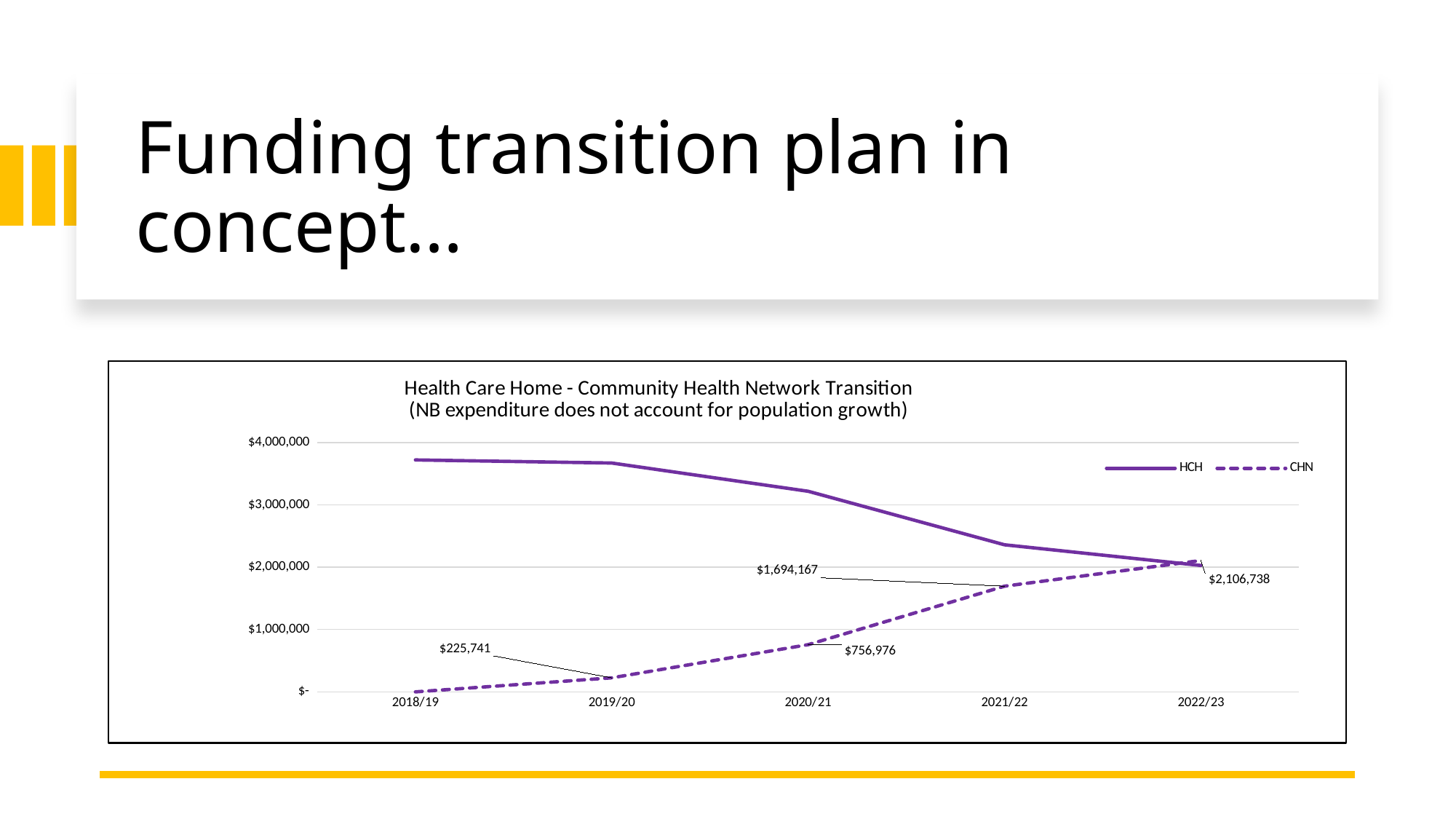
How many series does the legend list? 2 What is the CHN value for 2021/22? $1,694,167 What is the difference between the CHN values for 2021/22 and 2020/21? $937,191 Does the HCH line rise or fall from 2018/19 to 2022/23? fall What is the CHN value for 2020/21? $756,976 What is the CHN value for 2022/23? $2,106,738 In 2020/21, which series has the larger value, HCH or CHN? HCH What is the CHN value for 2019/20? $225,741 Is the HCH value for 2021/22 greater or less than $3,000,000? less What kind of chart is shown on the slide? line chart What is the difference between the CHN values for 2022/23 and 2021/22? $412,571 Is the HCH value for 2018/19 greater or less than $3,000,000? greater